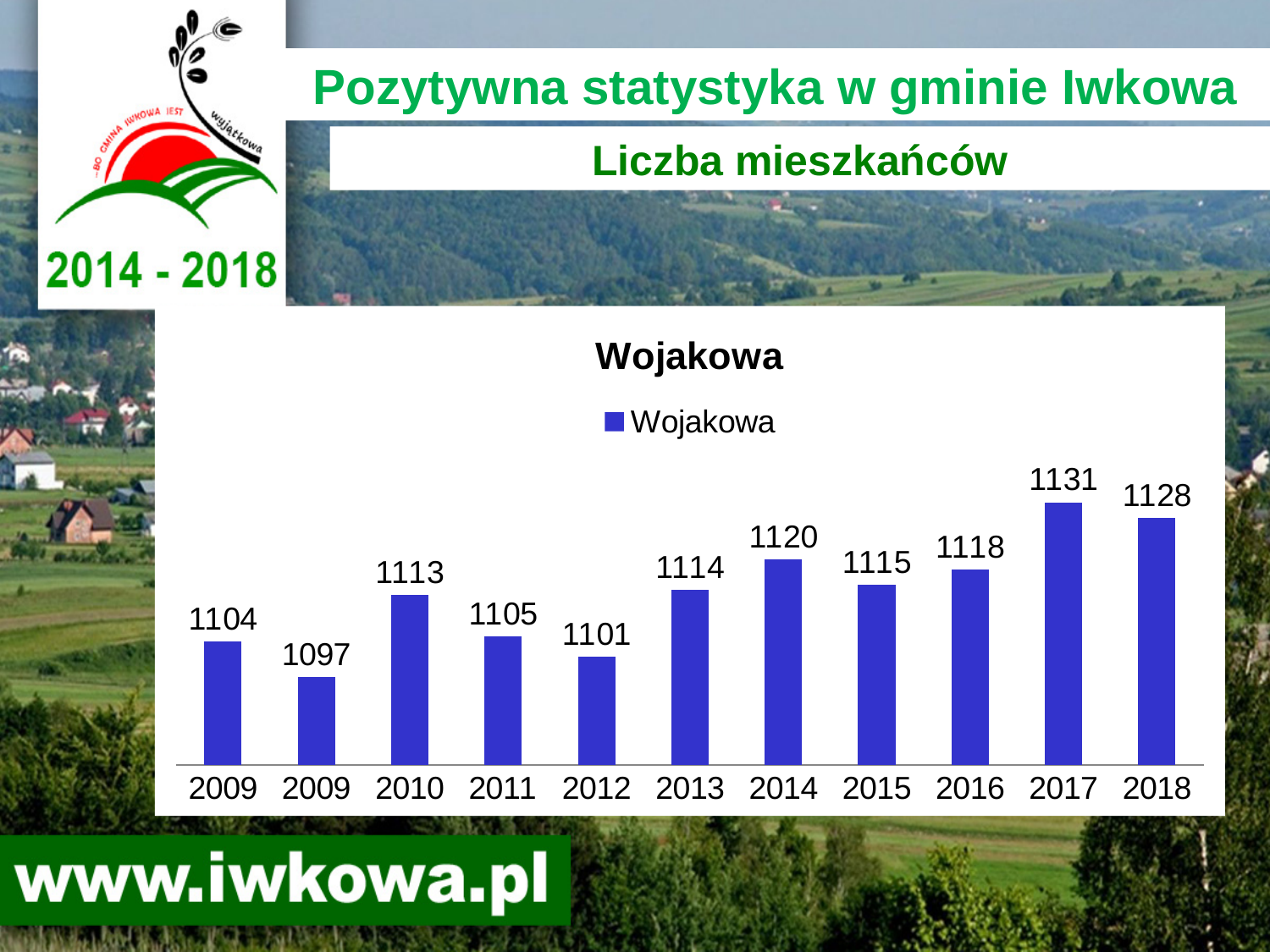
What kind of chart is shown? bar chart Which year has the highest value? 2017 What is the value for 2012? 1101 How many series does the legend list? 1 How many bars are shown on the chart? 11 What is the lowest value shown on the chart? 1097 What is the difference between the values for 2014 and 2013? 6 What is the value for 2018? 1128 What is the value for 2014? 1120 Which is larger, the value for 2014 or the value for 2015? 2014 What is the difference between the values for 2017 and 2018? 3 What is the value for 2017? 1131